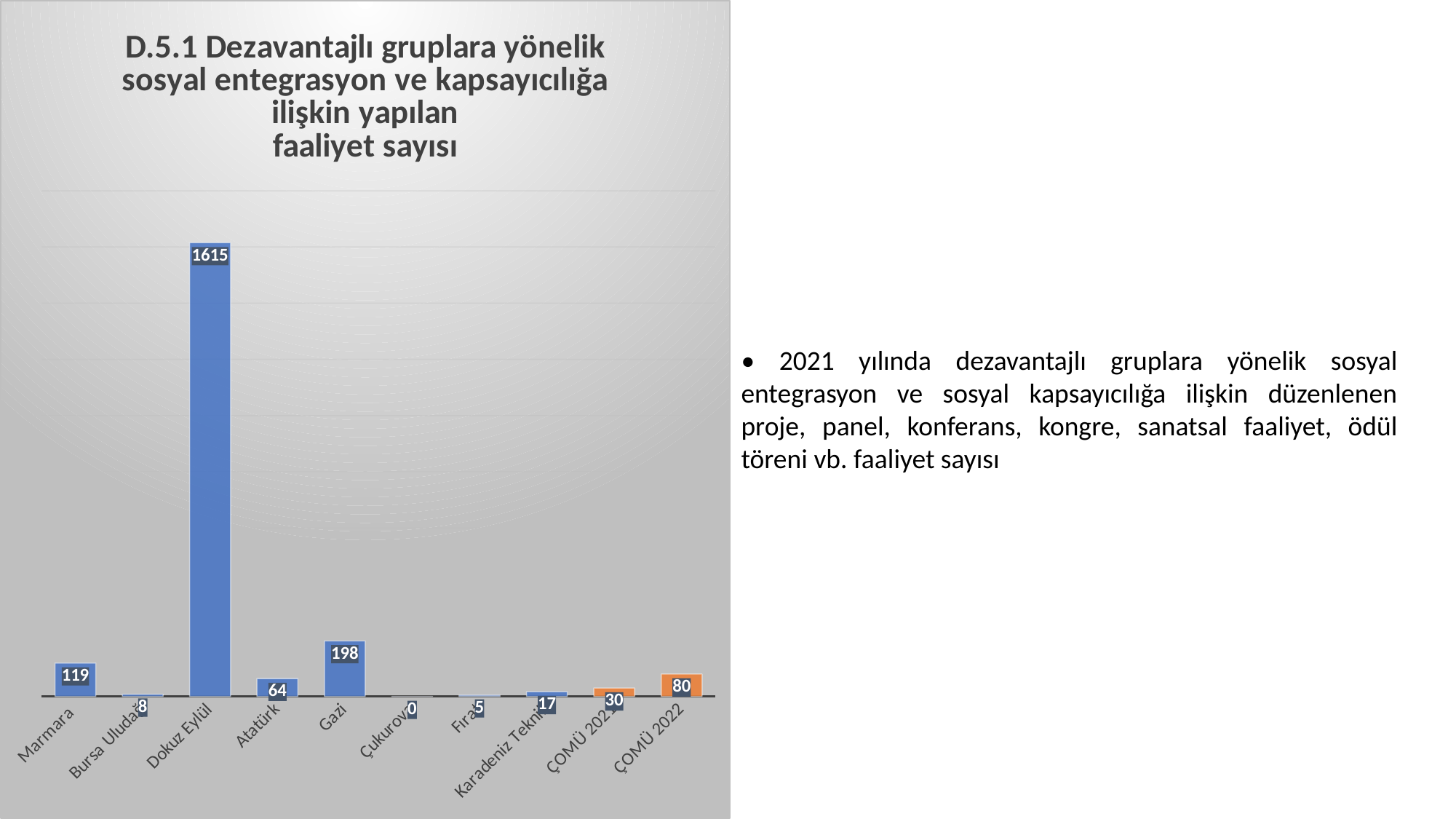
Which category has the highest value? Dokuz Eylül What is the value for ÇOMÜ 2022? 80 What kind of chart is shown on the slide? Bar chart What is the value for Gazi? 198 What is the difference between the values for Gazi and Marmara? 79 Which category has the lowest value? Çukurova Which is larger, the value for ÇOMÜ 2022 or the value for ÇOMÜ 2021? ÇOMÜ 2022 What is the value for Dokuz Eylül? 1615 What is the value for Karadeniz Teknik? 17 What is the value for Marmara? 119 How many categories are shown on the x axis? 10 What is the value for Atatürk? 64